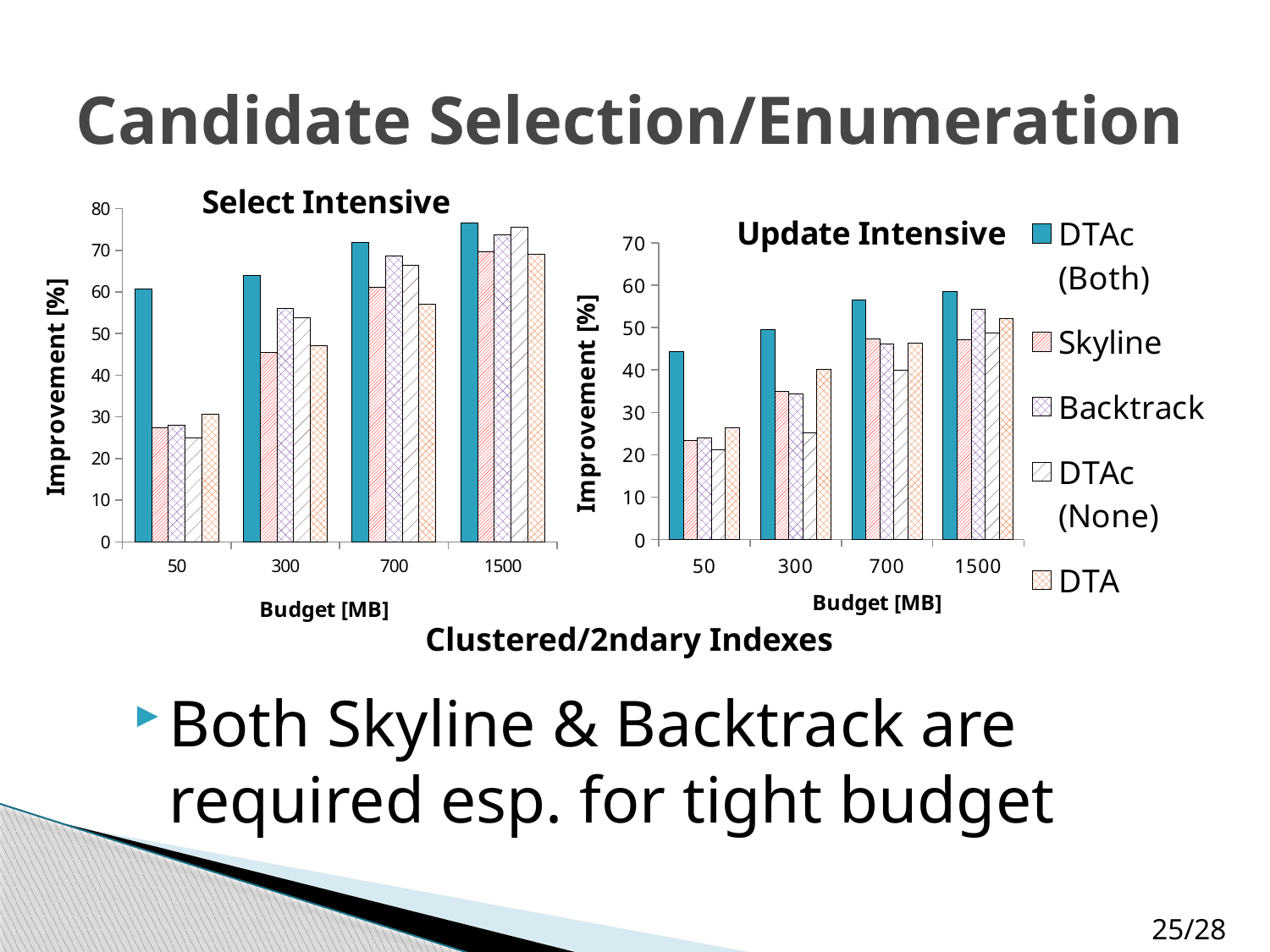
In the Select Intensive chart, at a budget of 50 MB, which is larger: DTAc (Both) or Skyline? DTAc (Both) In the Select Intensive chart, is the value for Skyline at a budget of 50 MB greater or less than 40? less In the Update Intensive chart, is the value for Skyline at a budget of 50 MB greater or less than 30? less What type of chart is the Select Intensive chart? bar chart In the Select Intensive chart, is the value for DTAc (Both) at a budget of 1500 MB greater or less than 70? greater How many budget categories are shown on the x axis of the Update Intensive chart? 4 In the Update Intensive chart, at which budget is the DTAc (Both) bar lowest? 50 In the Update Intensive chart, do the DTAc (Both) values rise or fall as the budget increases? rise How many series does the legend list for the charts? 5 In the Select Intensive chart, at which budget is the DTAc (Both) bar highest? 1500